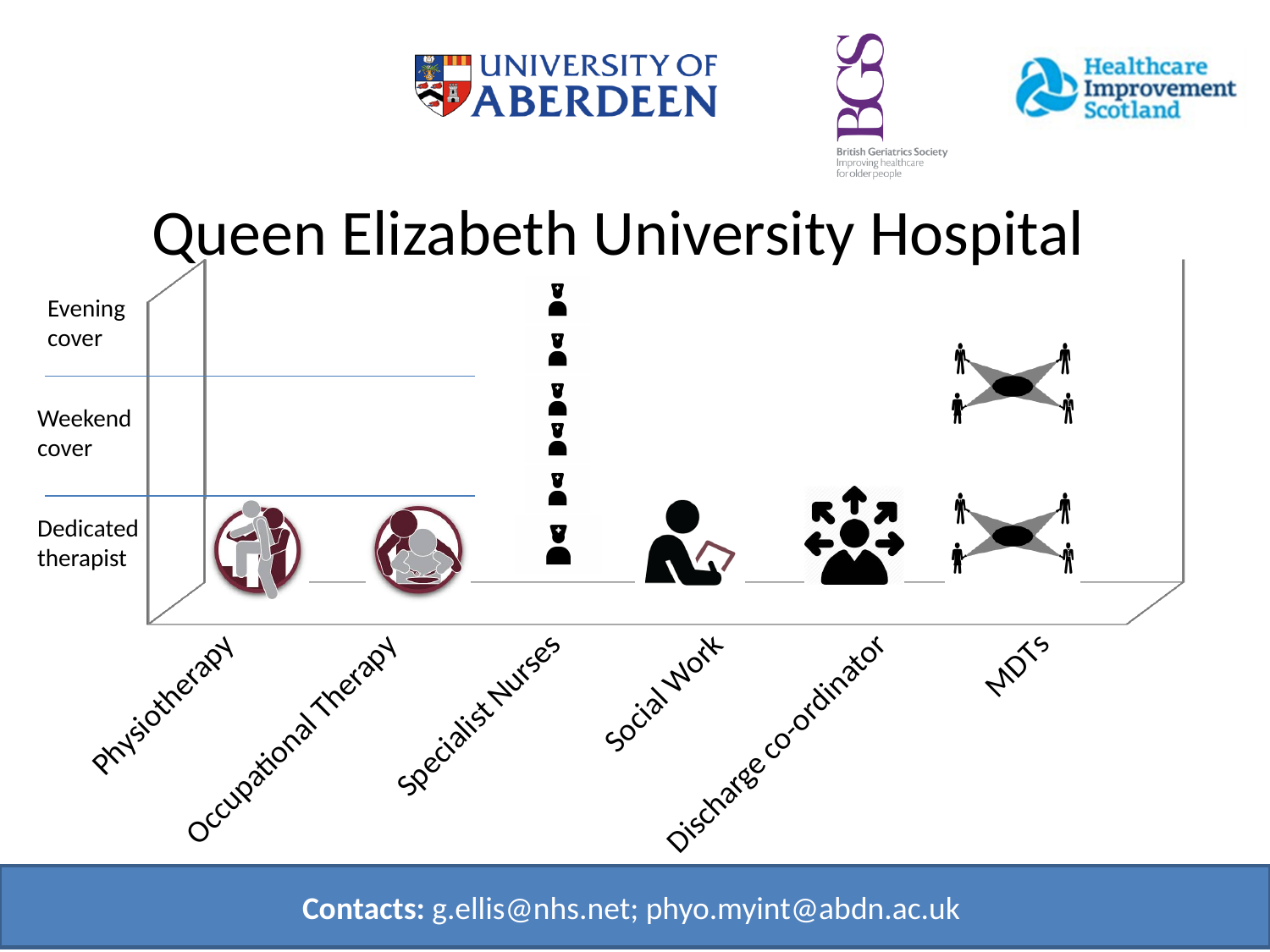
Which reaches a higher level on the chart, Specialist Nurses or Social Work? Specialist Nurses Which category reaches the highest level on the chart? Specialist Nurses What is the lowest level labelled on the vertical axis? Dedicated therapist How many nurse icons are stacked for Specialist Nurses? 6 Which reaches a higher level on the chart, Physiotherapy or MDTs? MDTs How many levels are labelled on the vertical axis of the chart? 3 How many categories are shown along the x axis of the chart? 6 How many team icons are stacked for MDTs? 2 Which category's icons reach the 'Evening cover' level? Specialist Nurses What is the label of the category between Specialist Nurses and Discharge co-ordinator? Social Work What is the title of the chart? Queen Elizabeth University Hospital Which category, other than Specialist Nurses, has icons reaching the 'Weekend cover' level? MDTs